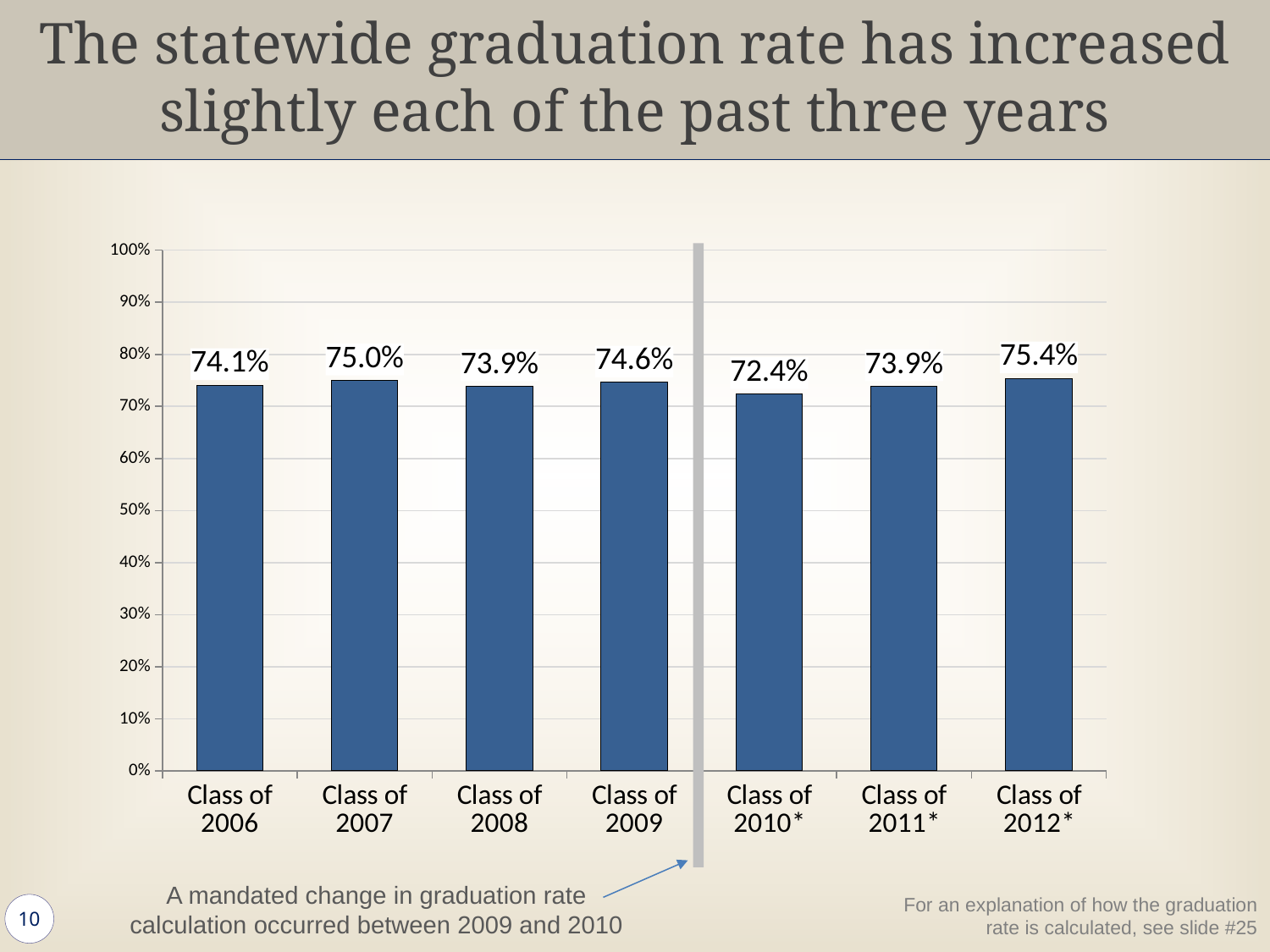
How many classes are shown in the chart? 7 What is the graduation rate for the Class of 2012*? 75.4% What is the graduation rate for the Class of 2010*? 72.4% What kind of chart is shown on the slide? bar chart What is the difference in graduation rate between the Class of 2012* and the Class of 2010*? 3.0% What is the graduation rate for the Class of 2006? 74.1% Which class has the lowest graduation rate? Class of 2010* Do the graduation rates rise or fall from the Class of 2010* to the Class of 2012*? rise What is the difference in graduation rate between the Class of 2007 and the Class of 2008? 1.1% Which has a higher graduation rate, the Class of 2009 or the Class of 2011*? Class of 2009 Is the graduation rate for the Class of 2007 greater or less than 80%? less Which class has the highest graduation rate? Class of 2012*